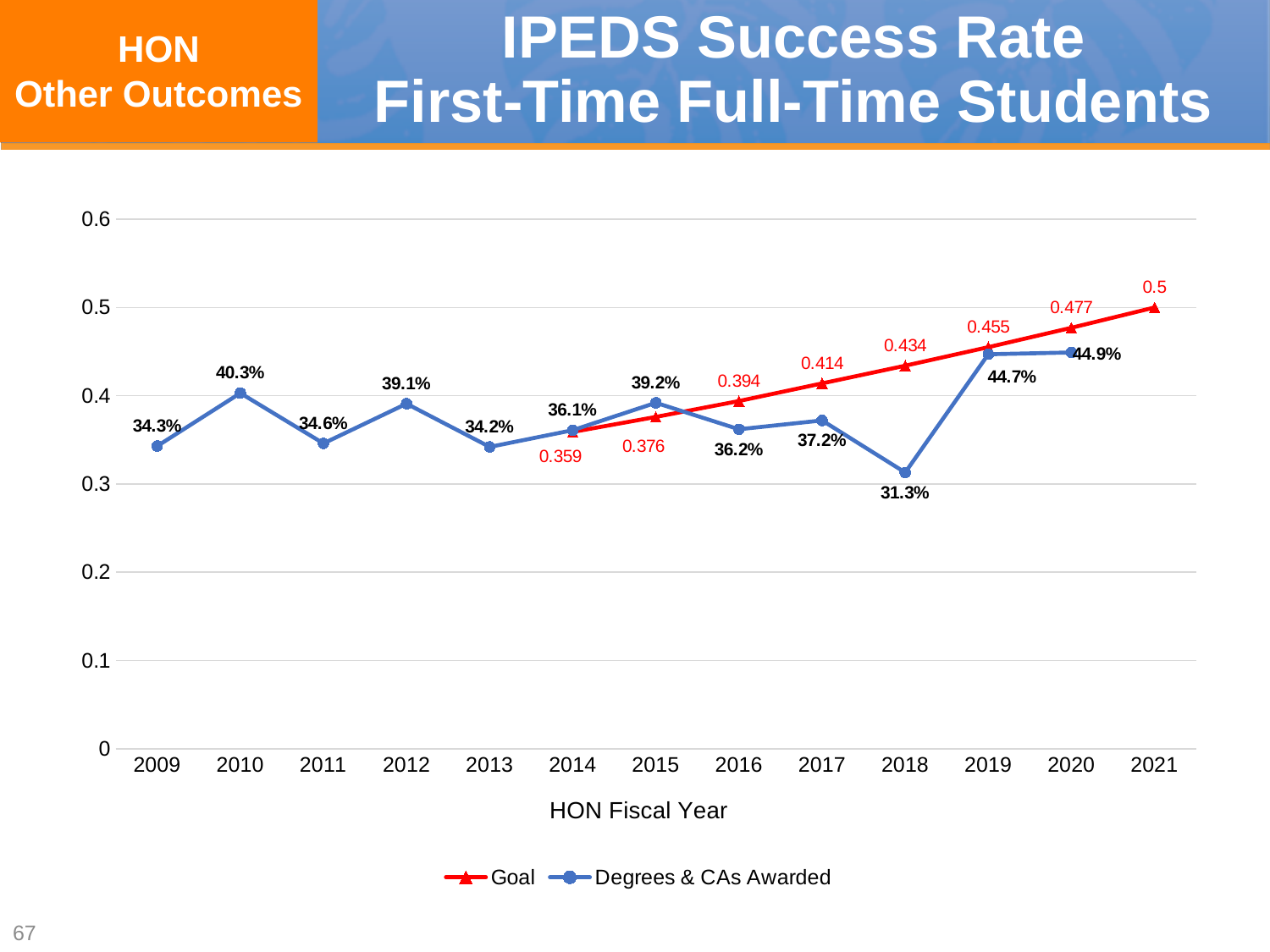
What is the Goal value for 2021? 0.5 In which year is the Degrees & CAs Awarded value highest? 2020 What is the Degrees & CAs Awarded value for 2013? 34.2% In which year is the Degrees & CAs Awarded value lowest? 2018 How many fiscal years are shown on the x axis? 13 How many series does the legend list? 2 By how many percentage points did Degrees & CAs Awarded change from 2018 to 2019? 13.4 percentage points What kind of chart is shown on the slide? line chart Is the Degrees & CAs Awarded value for 2018 greater or less than 0.4? less Which year has the higher Degrees & CAs Awarded value, 2010 or 2011? 2010 What is the Degrees & CAs Awarded value for 2020? 44.9% What is the Goal value for 2017? 0.414